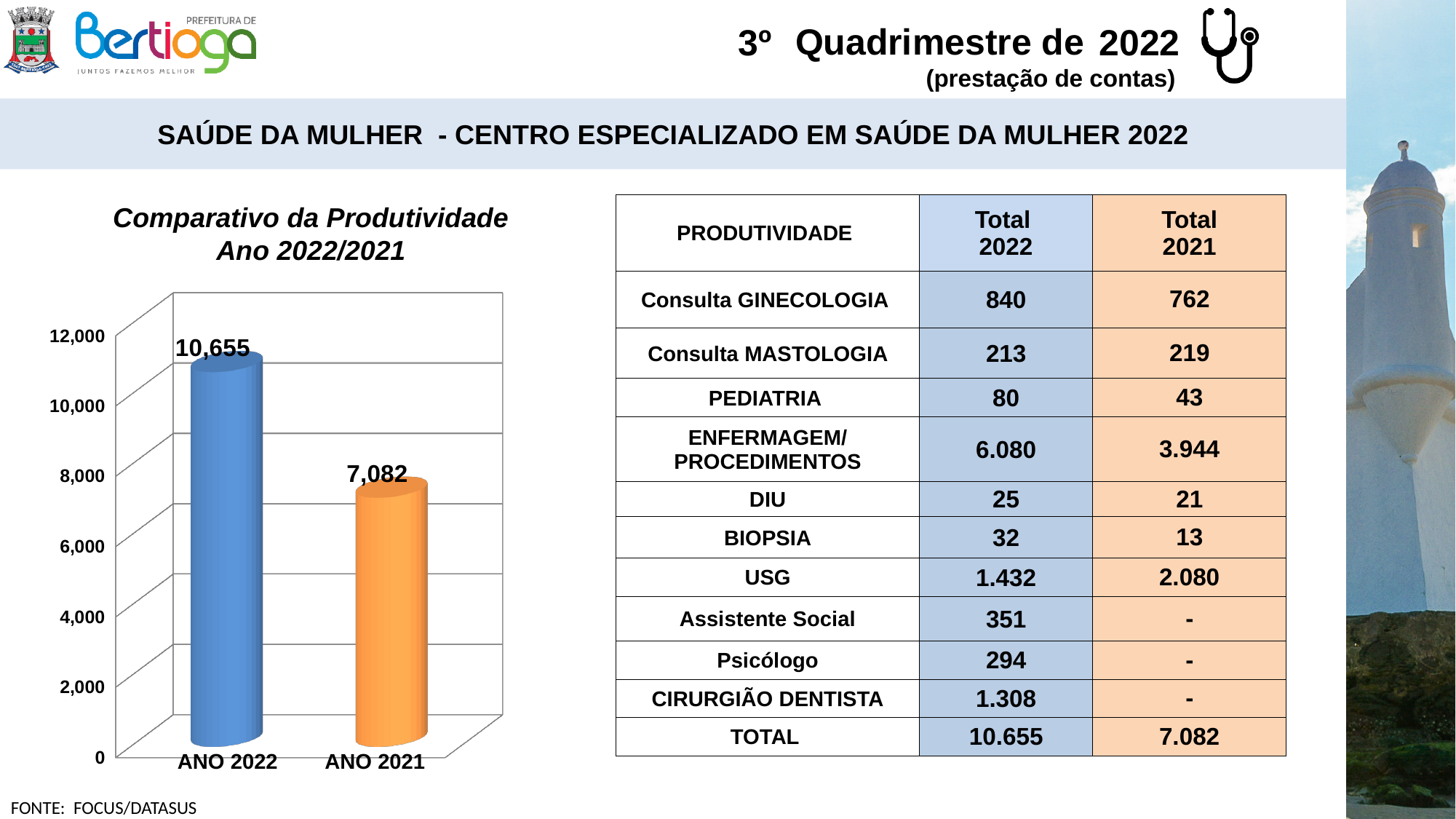
Is the value for ANO 2022 greater or less than 10,000? greater Which category has the lowest value in the chart? ANO 2021 What colour is the bar for ANO 2021? orange Which is larger, the value for ANO 2022 or ANO 2021? ANO 2022 What is the difference between the values for ANO 2022 and ANO 2021? 3,573 Is the value for ANO 2021 greater or less than 8,000? less Which category has the highest value in the chart? ANO 2022 What is the title of the chart? Comparativo da Produtividade Ano 2022/2021 What is the value for ANO 2022 in the chart? 10,655 How many categories are shown in the chart? 2 What is the value for ANO 2021 in the chart? 7,082 What kind of chart is shown on the slide? bar chart